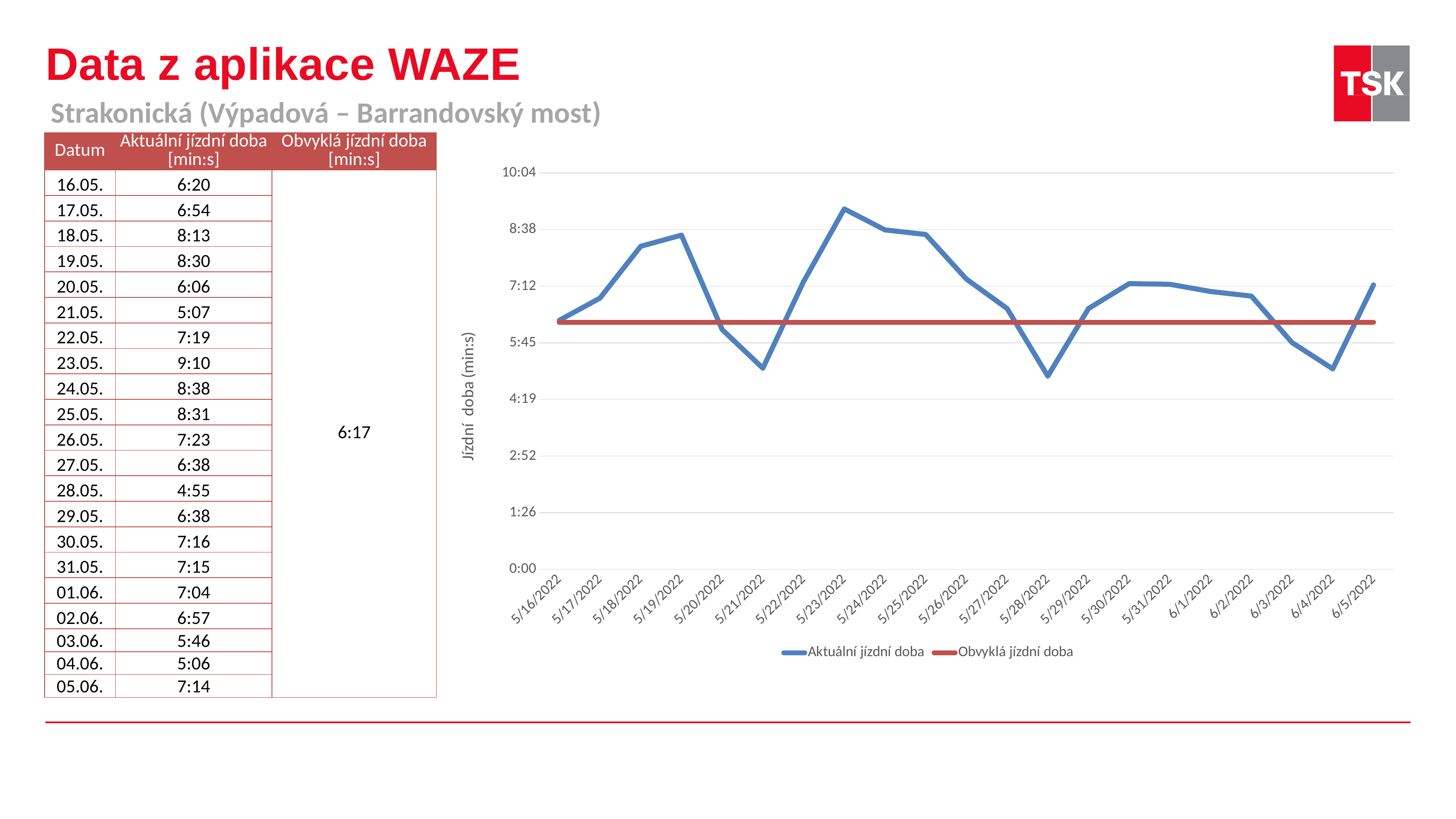
What kind of chart is shown on the slide? line chart Is the actual travel time on 5/28/2022 greater or less than 5:45? less On which date is the actual travel time highest? 23.05. How much longer is the actual travel time on 23.05. than the usual travel time of 6:17? 2:53 What is the title of the chart's vertical axis? Jízdní doba (min:s) What is the usual travel time (Obvyklá jízdní doba) shown by the red line? 6:17 What is the actual travel time (Aktuální jízdní doba) on 23.05.? 9:10 How many dates are plotted along the x axis of the chart? 21 Does the actual travel time rise or fall from 5/16/2022 to 5/19/2022? rise How many series does the chart legend list? 2 On which date is the actual travel time lowest? 28.05. Which date has a larger actual travel time, 18.05. or 26.05.? 18.05.